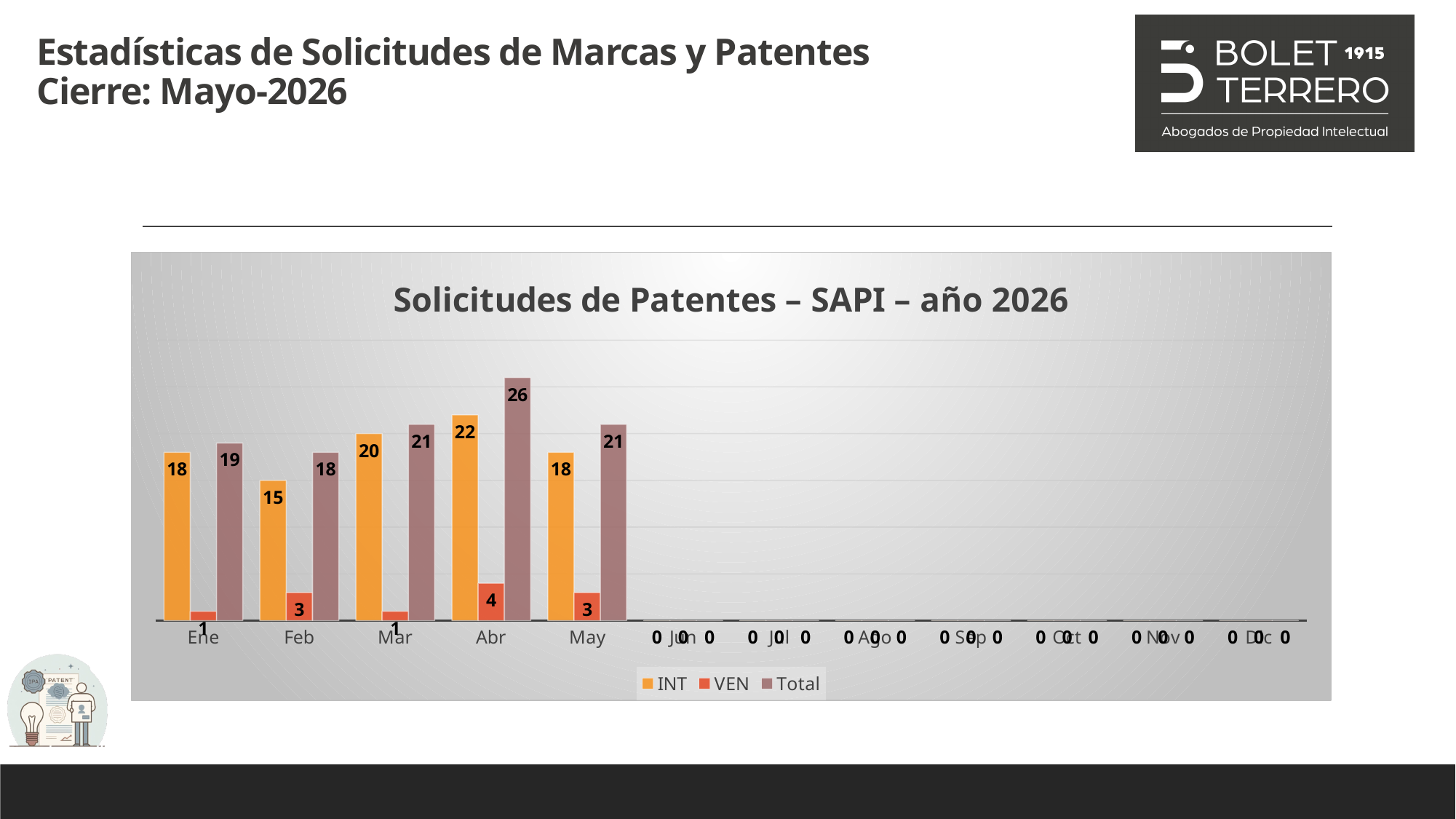
What is the Total value for Jun? 0 What is the INT value for Abr? 22 How many series does the legend list? 3 Which month has the highest Total value? Abr What is the Total value for Ene? 19 Among Ene to May, which month has the lowest INT value? Feb What kind of chart is shown on the slide? bar chart How many months are shown on the x axis? 12 What is the difference between the Total values for Abr and Feb? 8 Which is larger, the INT value for Mar or the INT value for May? Mar What is the title of the chart? Solicitudes de Patentes – SAPI – año 2026 What is the VEN value for Feb? 3